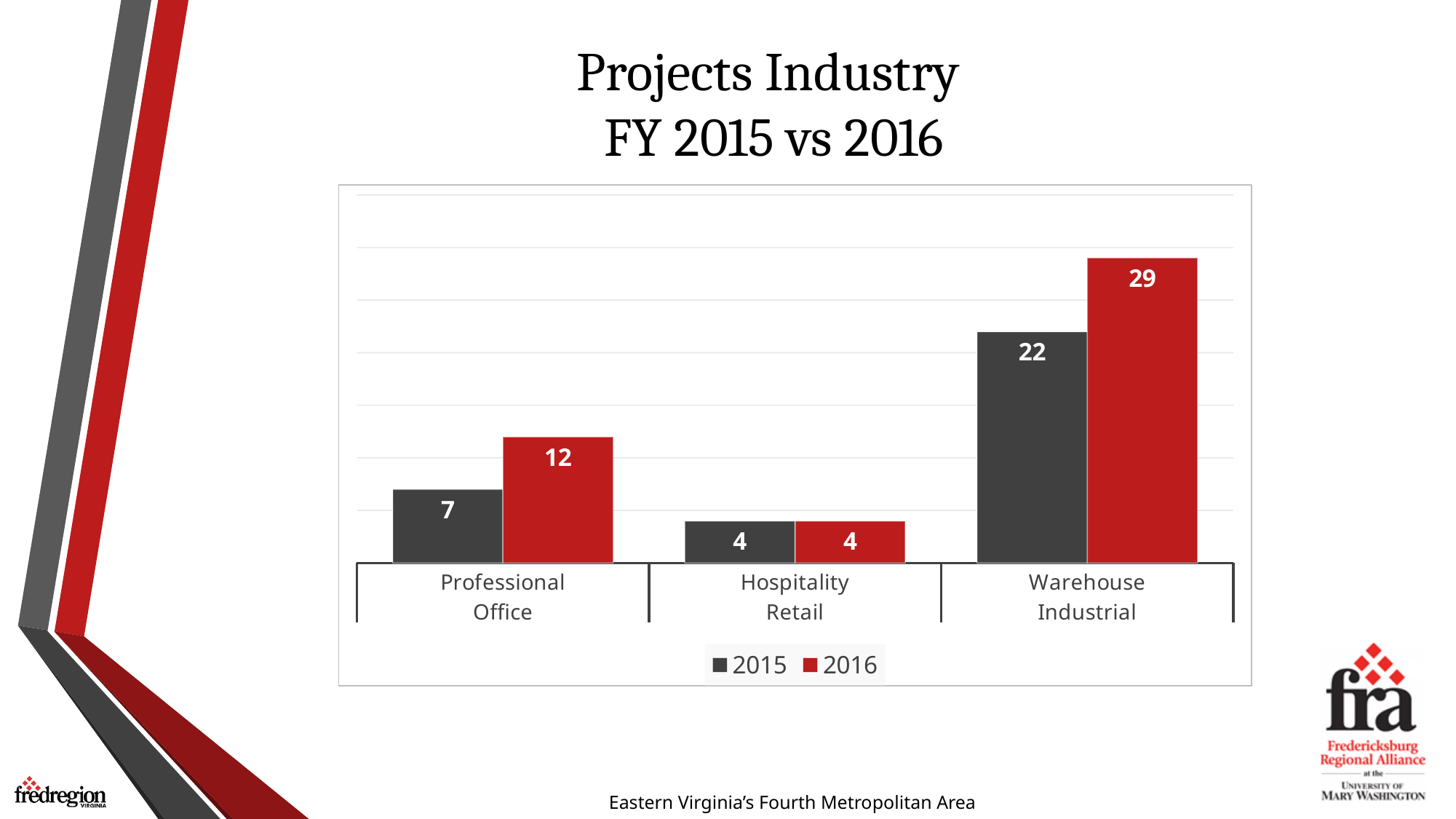
What is the difference between the 2016 and 2015 values for Professional Office? 5 How many series does the legend list? 2 What is the 2015 value for Professional Office? 7 What kind of chart is shown on the slide? Bar chart Which series is shown in red in the legend? 2016 Which category has the highest 2015 value? Warehouse Industrial How many categories are shown on the x axis? 3 Which is larger for Professional Office, the 2015 value or the 2016 value? 2016 What is the 2016 value for Hospitality Retail? 4 What is the difference between the 2016 and 2015 values for Warehouse Industrial? 7 Which category has the lowest 2016 value? Hospitality Retail What is the 2016 value for Warehouse Industrial? 29